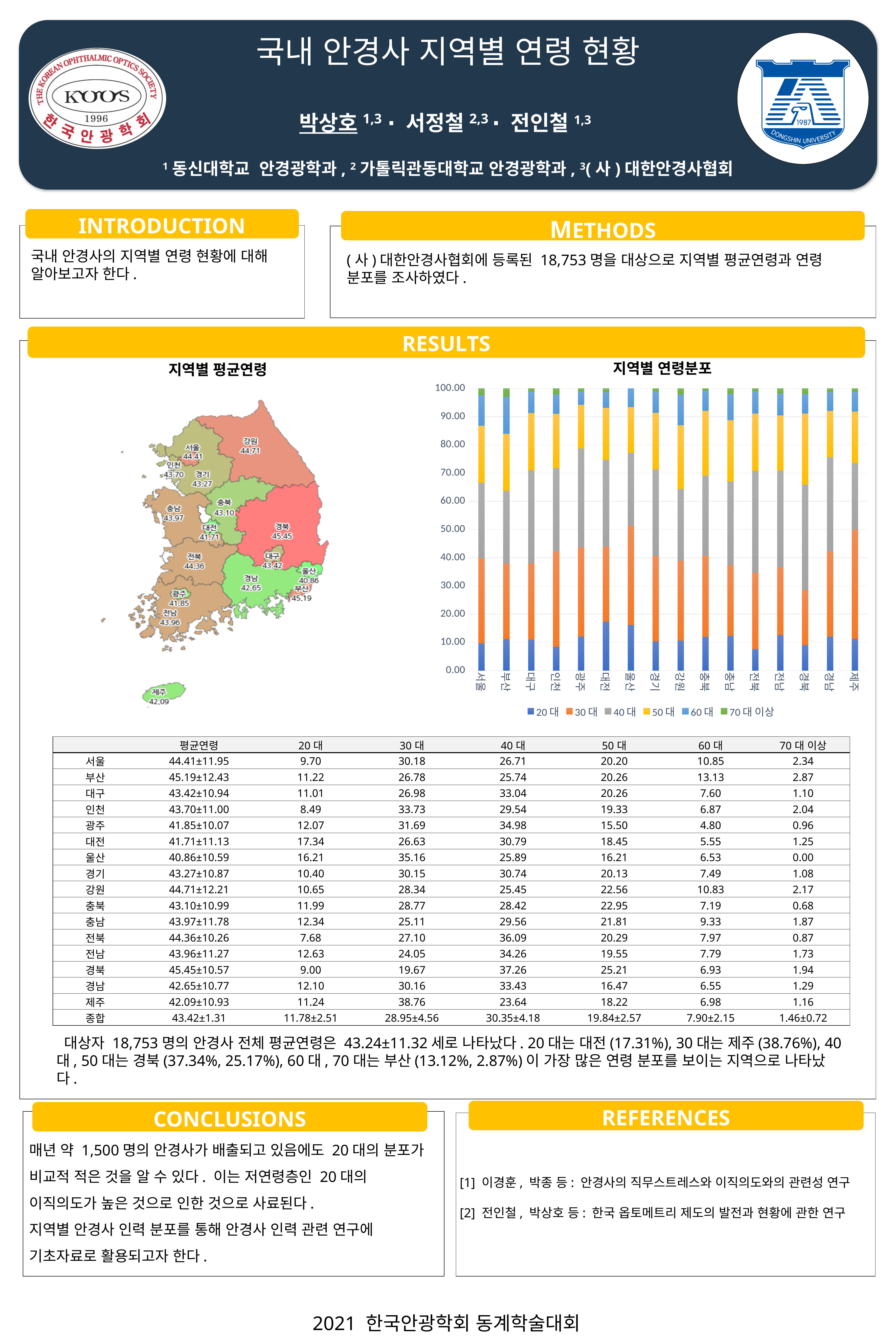
On the 지역별 연령분포 chart, which series is shown at the bottom of each stacked bar? 20 대 On the 지역별 평균연령 map chart, what is the difference between the average ages of 부산 and 대전? 3.48 On the 지역별 평균연령 map chart, what is the average age shown for 제주? 42.09 How many regions are shown on the x axis of the 지역별 연령분포 chart? 16 On the 지역별 평균연령 map chart, which has a higher average age, 서울 or 경기? 서울 On the 지역별 평균연령 map chart, which region has the lowest average age? 울산 On the 지역별 평균연령 map chart, what is the average age shown for 경북? 45.45 On the 지역별 연령분포 chart, is the 20 대 value for 대전 greater or less than 10.00? greater On the 지역별 평균연령 map chart, which region has the highest average age? 경북 How many series does the legend of the 지역별 연령분포 chart list? 6 What kind of chart is the 지역별 연령분포 chart? Stacked bar chart On the 지역별 평균연령 map chart, what is the average age shown for 울산? 40.86